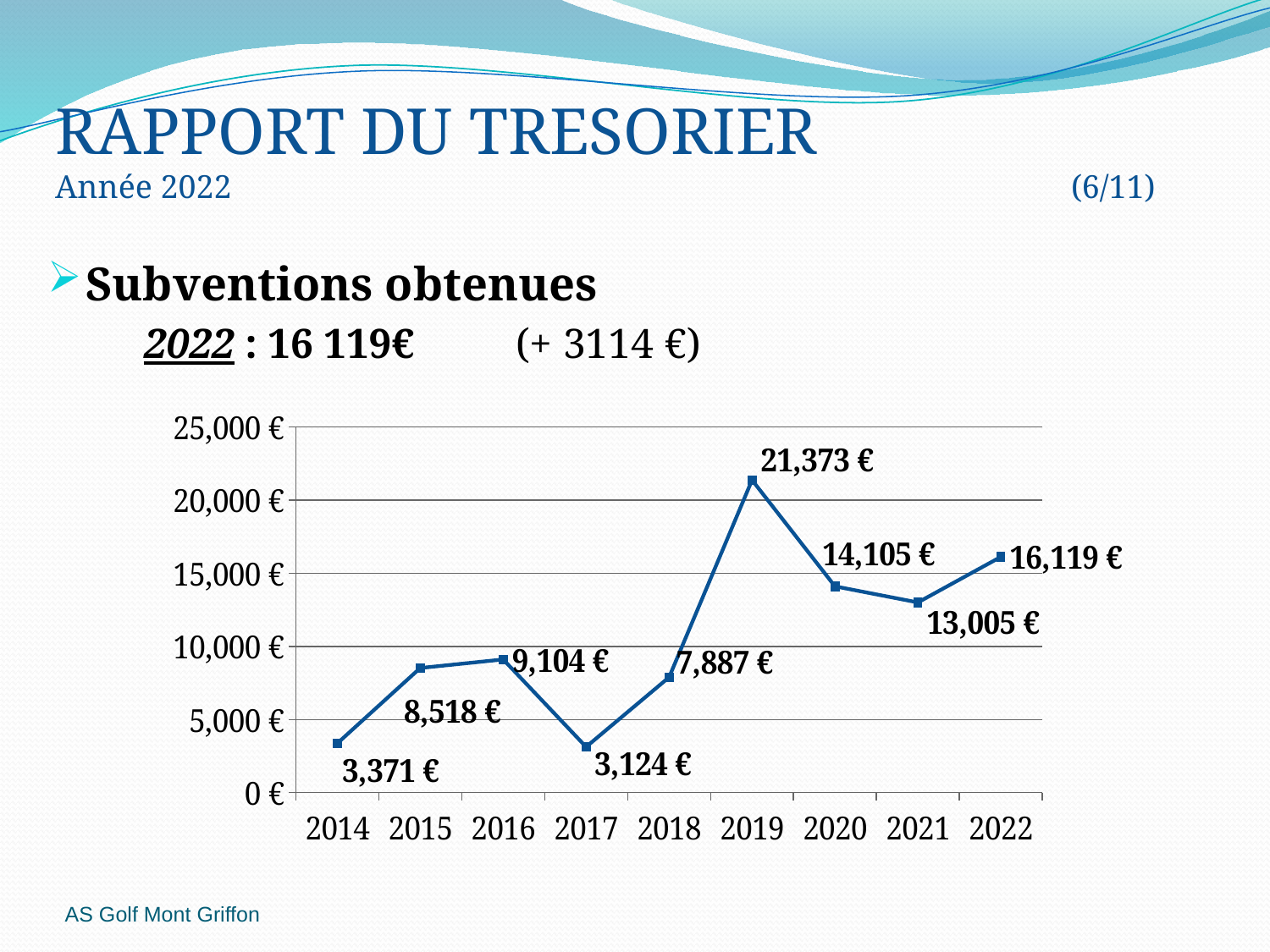
What is the value for 2019? 21,373 € Do the values rise or fall from 2019 to 2021? fall What is the value for 2014? 3,371 € Which year has the lowest value? 2017 What is the value for 2021? 13,005 € What type of chart is shown on the slide? line chart Is the value for 2020 greater or less than 15,000 €? less How many years are plotted on the x axis? 9 Which is larger, the value for 2016 or the value for 2018? 2016 Which year has the highest value? 2019 What is the difference between the values for 2022 and 2021? 3,114 € What is the difference between the values for 2019 and 2020? 7,268 €